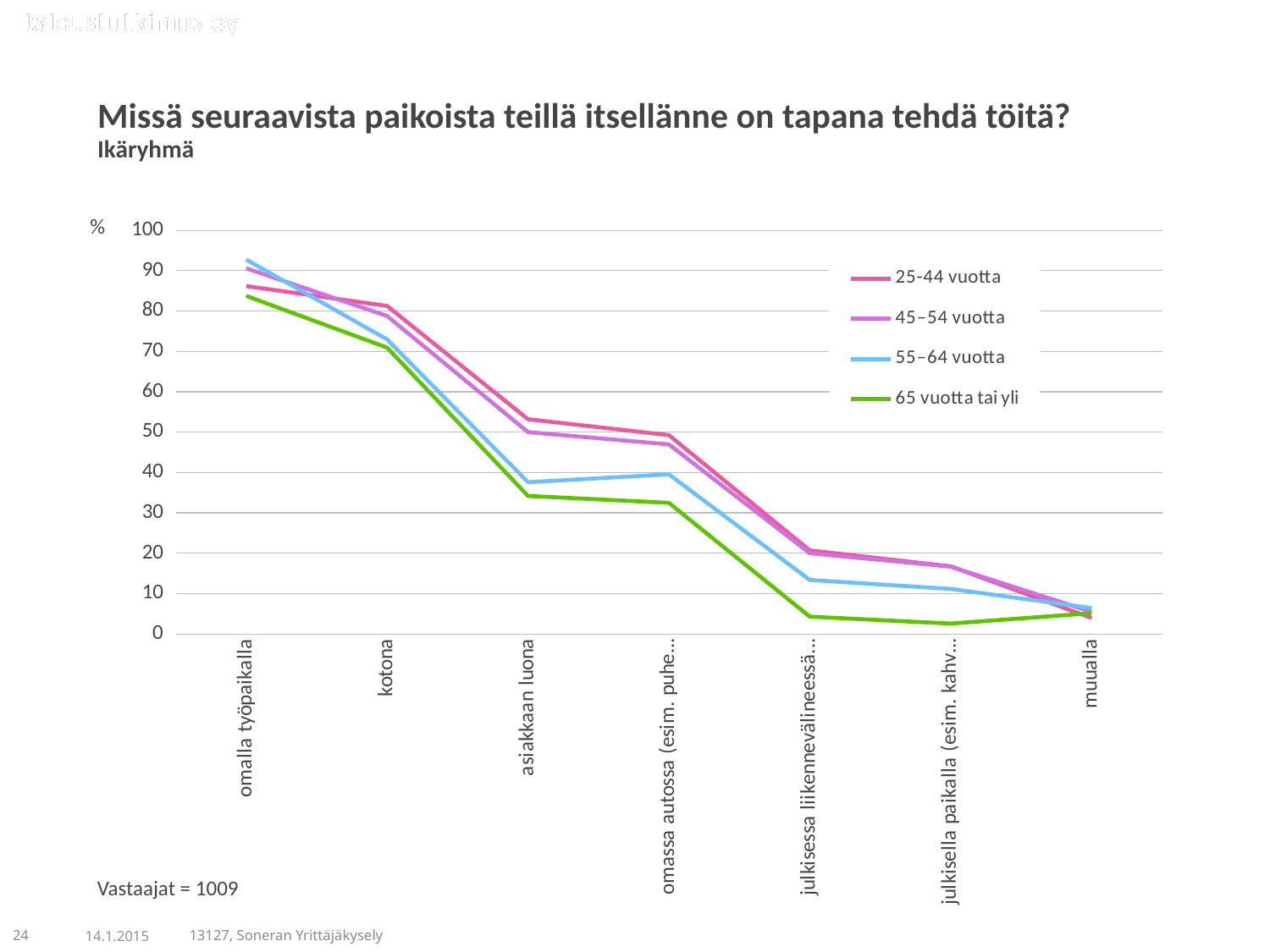
For the 65 vuotta tai yli series, which category has the lowest value? julkisella paikalla (esim. kahv...) Is the value for 25-44 vuotta at asiakkaan luona greater or less than 40? greater At kotona, which series has the larger value: 25-44 vuotta or 65 vuotta tai yli? 25-44 vuotta How many series does the legend list? 4 How many categories are plotted along the x axis? 7 For the 55–64 vuotta series, which category has the highest value? omalla työpaikalla Is the value for 65 vuotta tai yli at kotona greater or less than 80? less Is the value for 55–64 vuotta at julkisessa liikennevälineessä greater or less than 20? less What kind of chart is shown on the slide? line chart At asiakkaan luona, which series has the larger value: 45–54 vuotta or 55–64 vuotta? 45–54 vuotta What is the title of the chart? Missä seuraavista paikoista teillä itsellänne on tapana tehdä töitä? Does the 65 vuotta tai yli line rise or fall from omalla työpaikalla to julkisella paikalla? fall